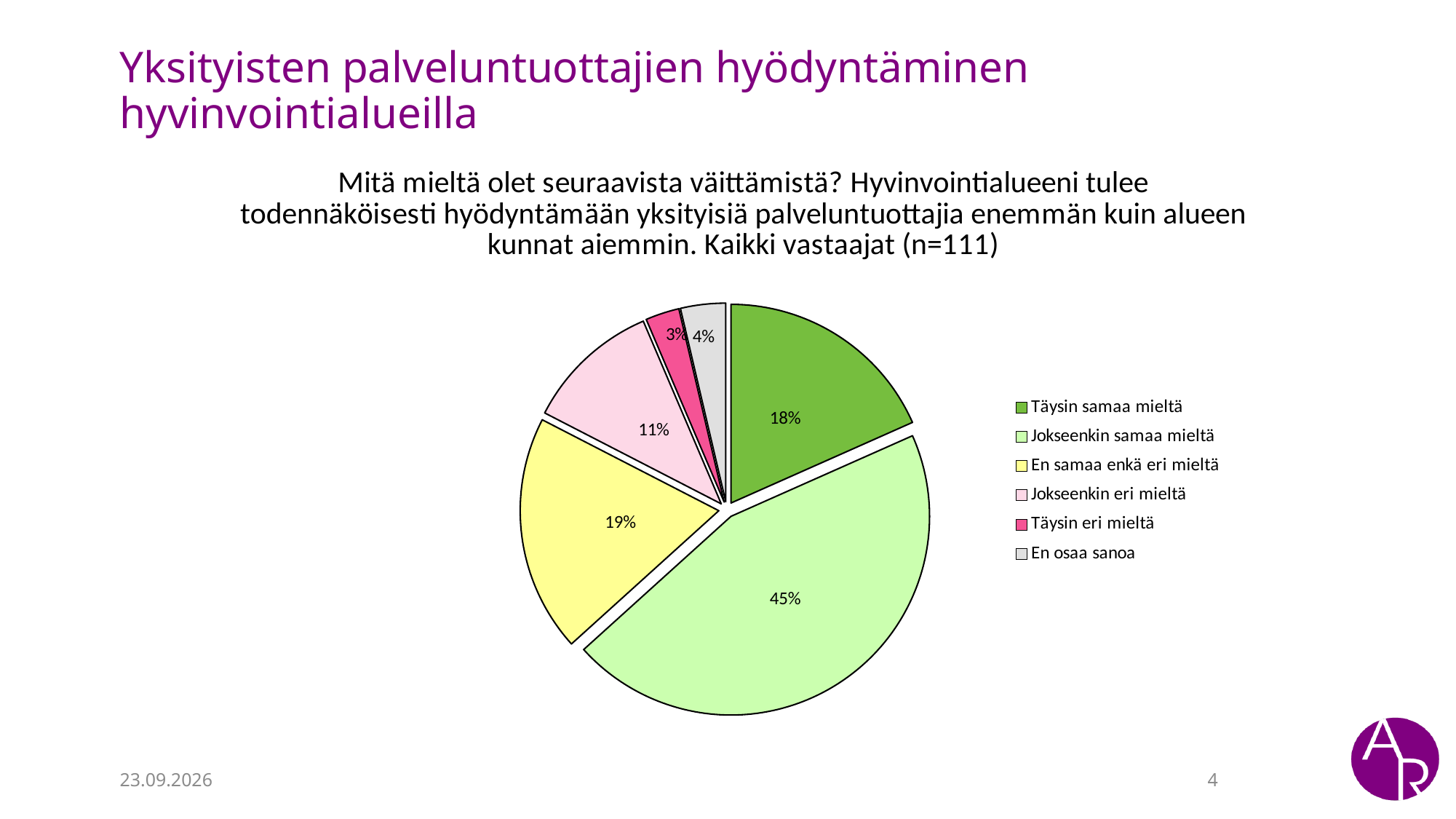
What share of respondents answered "Jokseenkin samaa mieltä"? 45% Which is larger: the share for "En samaa enkä eri mieltä" or the share for "Jokseenkin eri mieltä"? En samaa enkä eri mieltä What share of respondents answered "En osaa sanoa"? 4% What is the difference in percentage points between "Jokseenkin samaa mieltä" and "Täysin samaa mieltä"? 27 Which response category has the smallest share of the pie? Täysin eri mieltä What type of chart is shown on the slide? pie chart Which response category has the largest share of the pie? Jokseenkin samaa mieltä How many categories does the legend list? 6 What share of respondents answered "Täysin eri mieltä"? 3% What share of respondents answered "Täysin samaa mieltä"? 18% What share of respondents answered "En samaa enkä eri mieltä"? 19% What share of respondents answered "Jokseenkin eri mieltä"? 11%